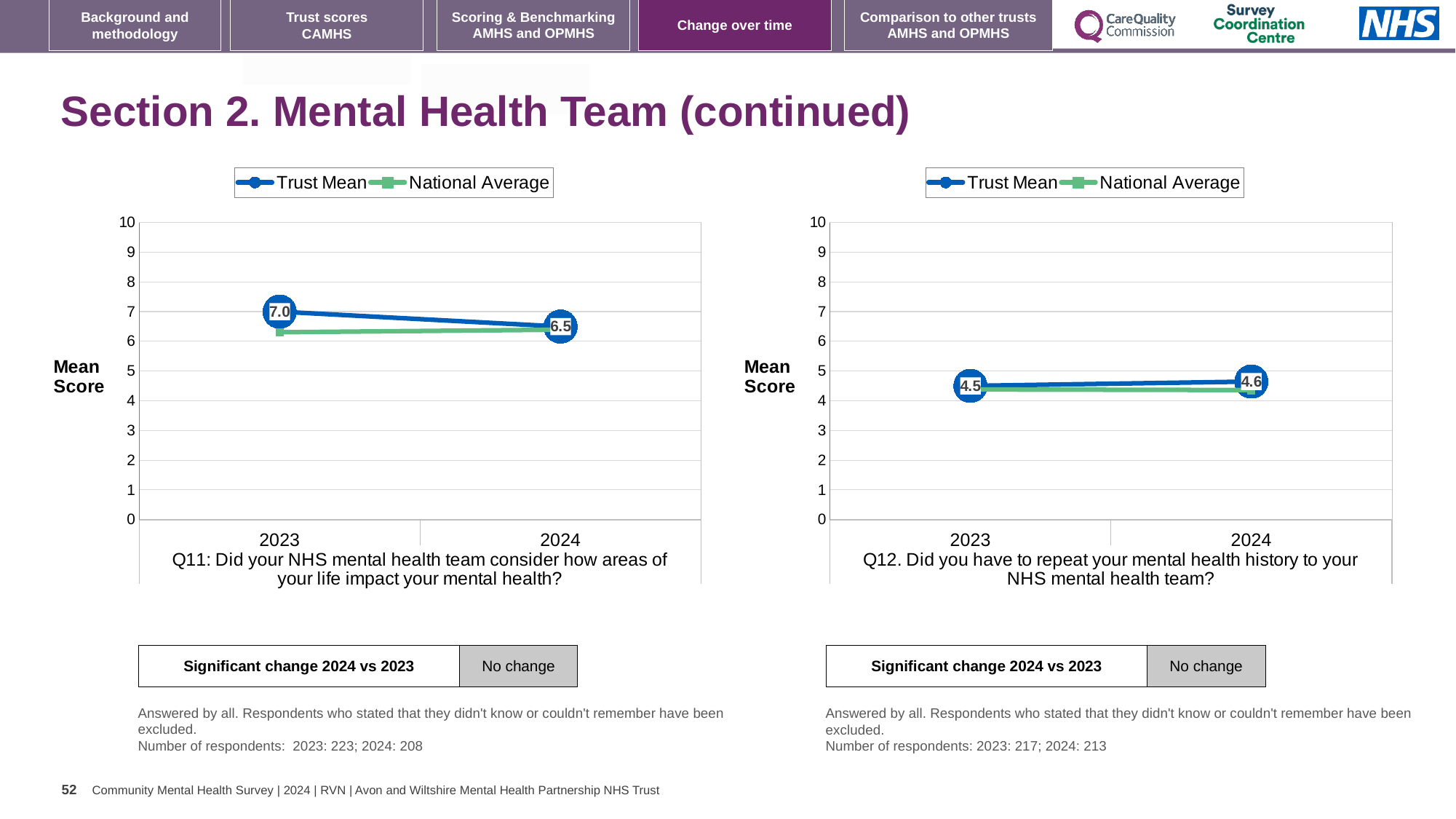
In the Q11 chart on the left, what is the Trust Mean score for 2023? 7.0 In the Q11 chart on the left, what is the Trust Mean score for 2024? 6.5 How many years are shown on the x axis of the Q11 chart on the left? 2 What kind of chart is the Q11 chart on the left? line chart In the Q12 chart on the right, does the Trust Mean rise or fall from 2023 to 2024? rise In the Q11 chart on the left, by how much did the Trust Mean change from 2023 to 2024? 0.5 In the Q11 chart on the left, is the National Average for 2023 greater or less than 7? less In the Q12 chart on the right, what is the Trust Mean score for 2024? 4.6 In the Q12 chart on the right, what is the Trust Mean score for 2023? 4.5 In the Q11 chart on the left, which is larger for 2023, the Trust Mean or the National Average? Trust Mean How many series does the legend of the Q12 chart on the right list? 2 In the Q11 chart on the left, does the Trust Mean rise or fall from 2023 to 2024? fall